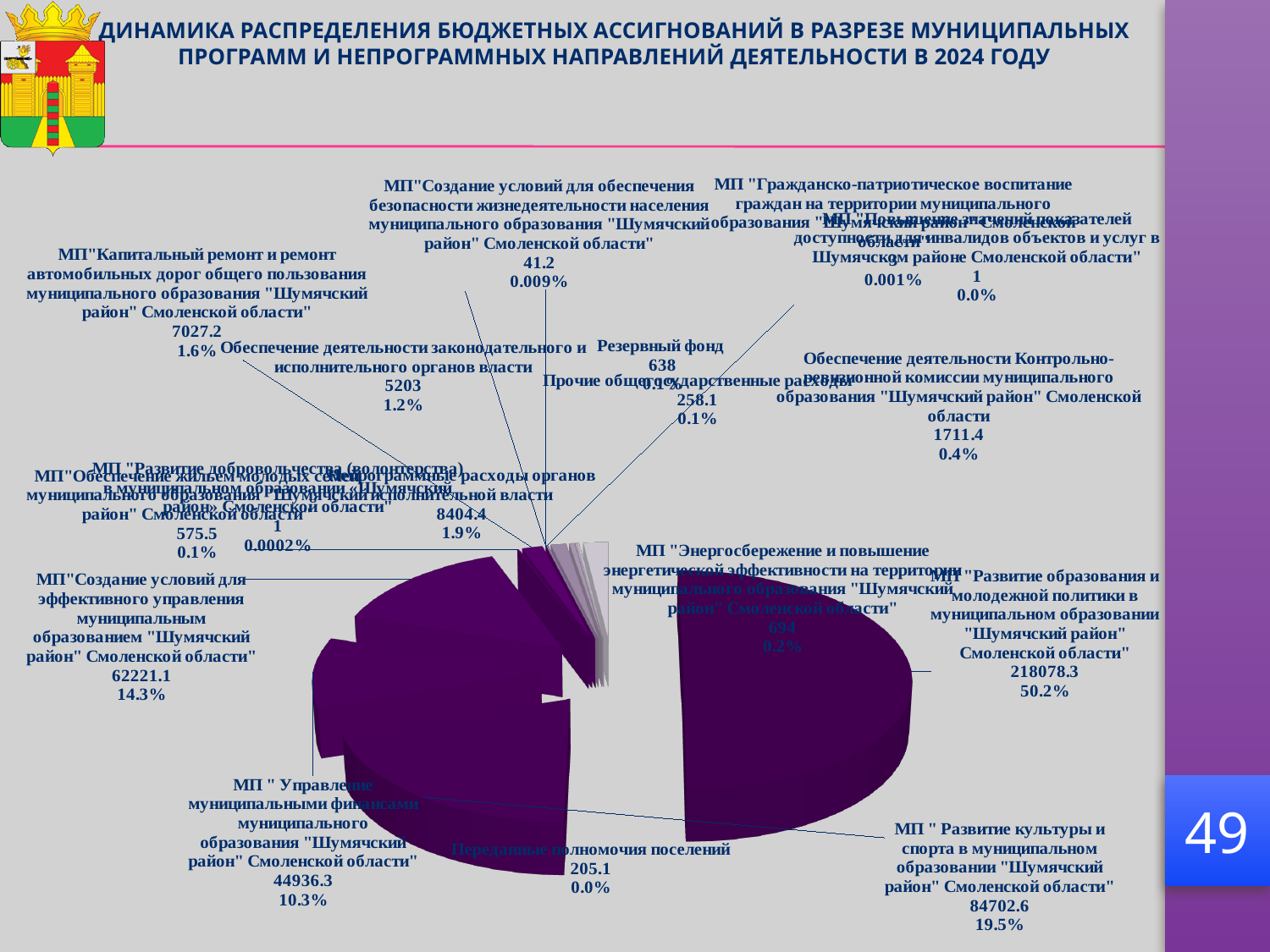
Which category has the largest share of the pie? МП "Развитие образования и молодежной политики в муниципальном образовании "Шумячский район" Смоленской области" What is the value shown for МП "Развитие культуры и спорта в муниципальном образовании "Шумячский район" Смоленской области"? 84702.6 What is the difference between the values for МП "Развитие образования и молодежной политики" and МП "Развитие культуры и спорта"? 133375.7 What is the value shown for Переданные полномочия поселений? 205.1 What share of the pie does МП "Развитие образования и молодежной политики" account for? 50.2% What percentage is shown for МП "Создание условий для эффективного управления муниципальным образованием"? 14.3% Which is larger: the value for МП "Развитие культуры и спорта" or the value for МП "Управление муниципальными финансами"? МП "Развитие культуры и спорта" What is the value shown for Резервный фонд? 638 What is the value shown for Обеспечение деятельности законодательного и исполнительного органов власти? 5203 What is the value shown for МП "Управление муниципальными финансами муниципального образования"? 44936.3 What percentage is shown for МП "Капитальный ремонт и ремонт автомобильных дорог общего пользования"? 1.6% What kind of chart is shown on the slide? pie chart